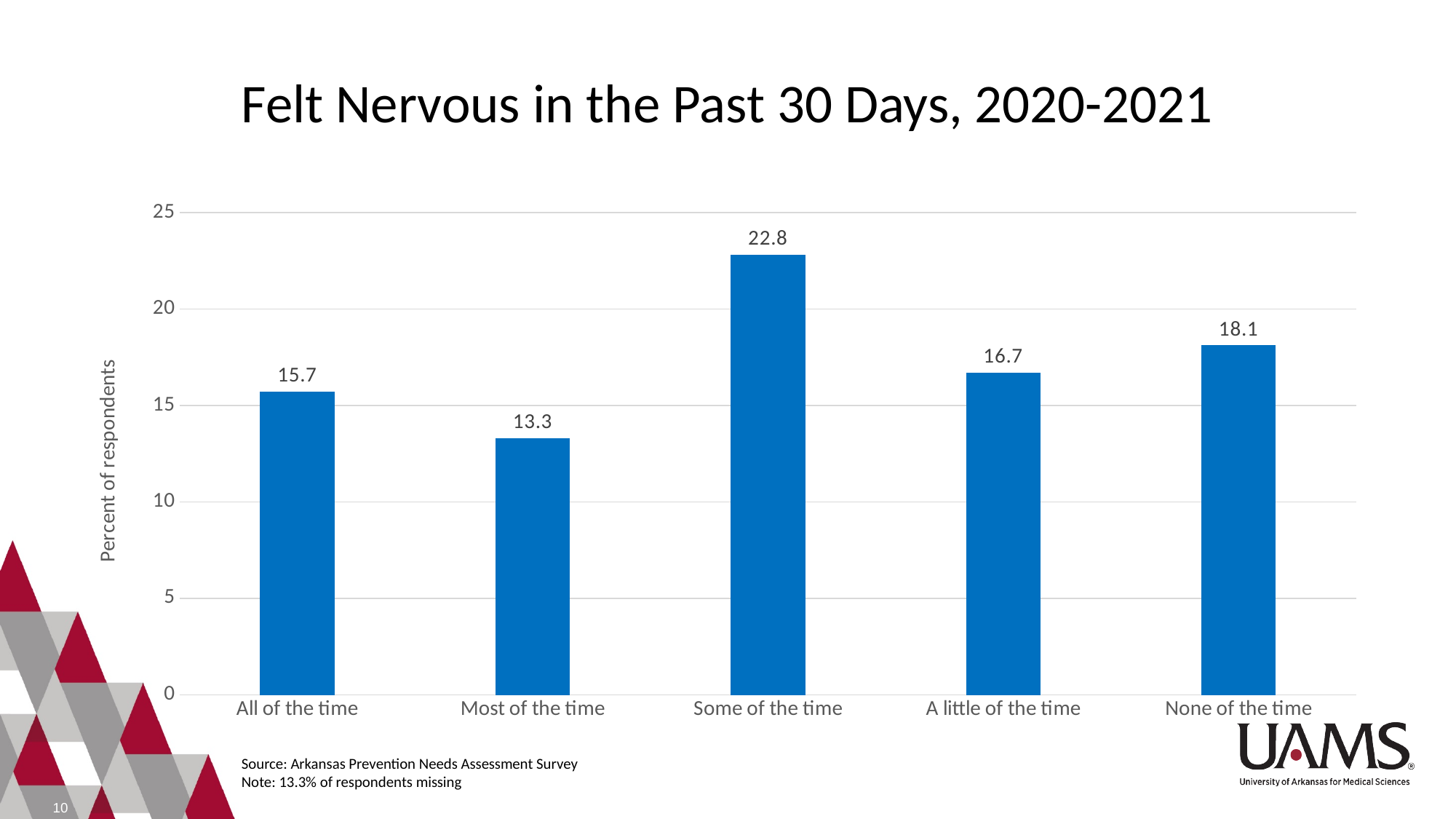
What is the value for "None of the time"? 18.1 What is the value for "Most of the time"? 13.3 What is the difference between the values for "None of the time" and "A little of the time"? 1.4 Which category has the lowest value? Most of the time What is the value for "Some of the time"? 22.8 What is the label of the y axis? Percent of respondents Which category has the highest value? Some of the time Is the value for "Some of the time" greater or less than 20? greater What is the difference between the values for "Some of the time" and "Most of the time"? 9.5 What kind of chart is shown on the slide? bar chart Which is larger, the value for "All of the time" or the value for "A little of the time"? A little of the time How many categories are shown on the x axis? 5